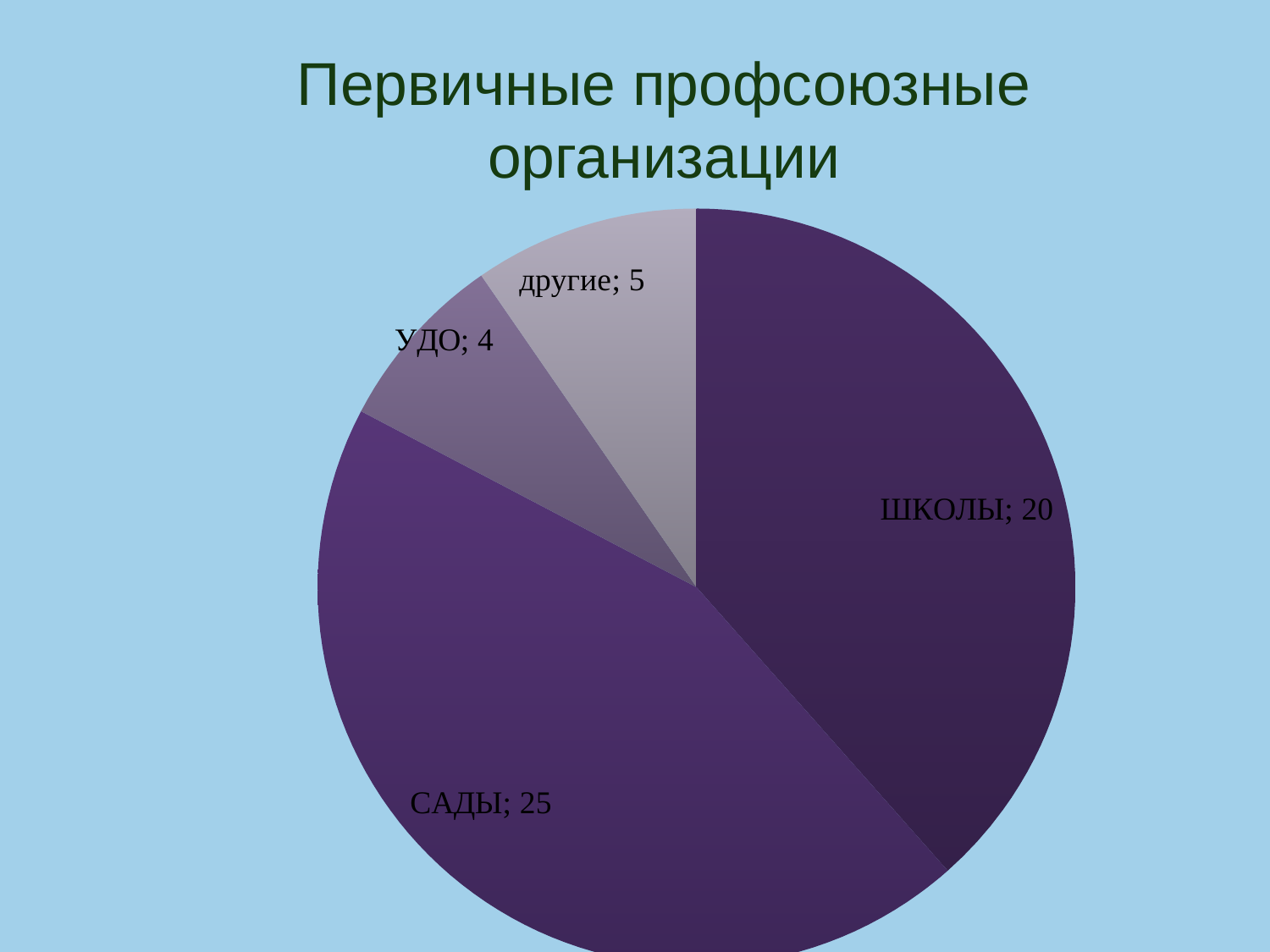
What is the value for другие? 5 What is the total of all slices in the pie chart? 54 How many slices does the pie chart have? 4 Which category has the smallest slice? УДО What type of chart is shown on the slide? pie chart Which category has the largest slice? САДЫ What is the value for САДЫ? 25 What is the value for УДО? 4 What is the value for ШКОЛЫ? 20 What is the title of the slide containing the chart? Первичные профсоюзные организации What is the difference between the values for САДЫ and ШКОЛЫ? 5 Which is larger, the value for другие or the value for УДО? другие